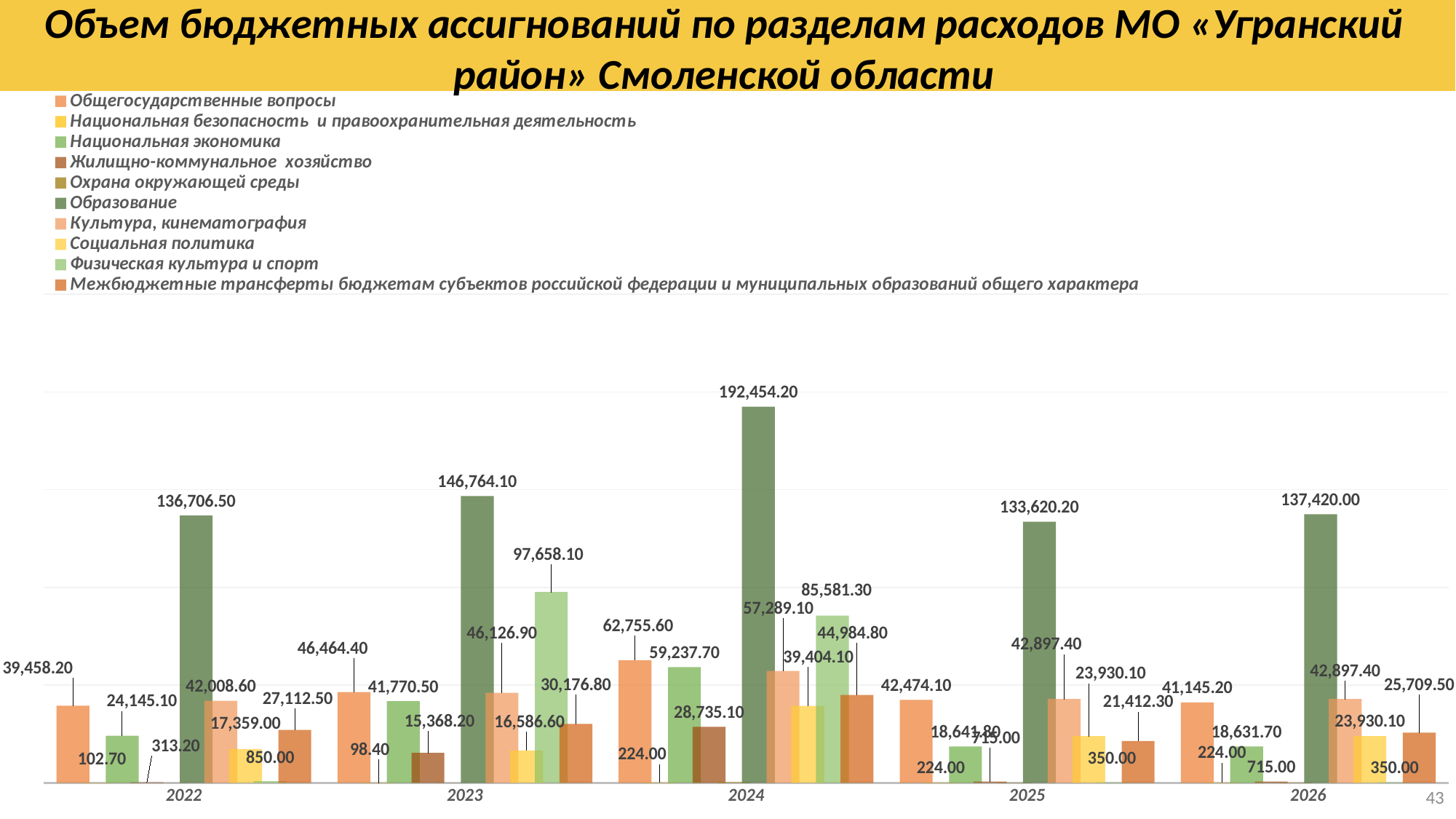
What is the value for Образование in 2024? 192,454.20 What is the value for Межбюджетные трансферты бюджетам субъектов российской федерации и муниципальных образований общего характера in 2026? 25,709.50 How many years are shown on the x axis? 5 What is the difference between the Образование values for 2024 and 2023? 45,690.10 In which year is the value for Образование the highest? 2024 In 2024, which is larger: Общегосударственные вопросы or Национальная экономика? Общегосударственные вопросы In which year is the value for Образование the lowest? 2025 How many series does the legend list? 10 What kind of chart is shown on the slide? Bar chart What is the difference between the Физическая культура и спорт values for 2023 and 2024? 12,076.80 Does the value for Общегосударственные вопросы rise or fall from 2022 to 2024? Rises What is the value for Физическая культура и спорт in 2023? 97,658.10